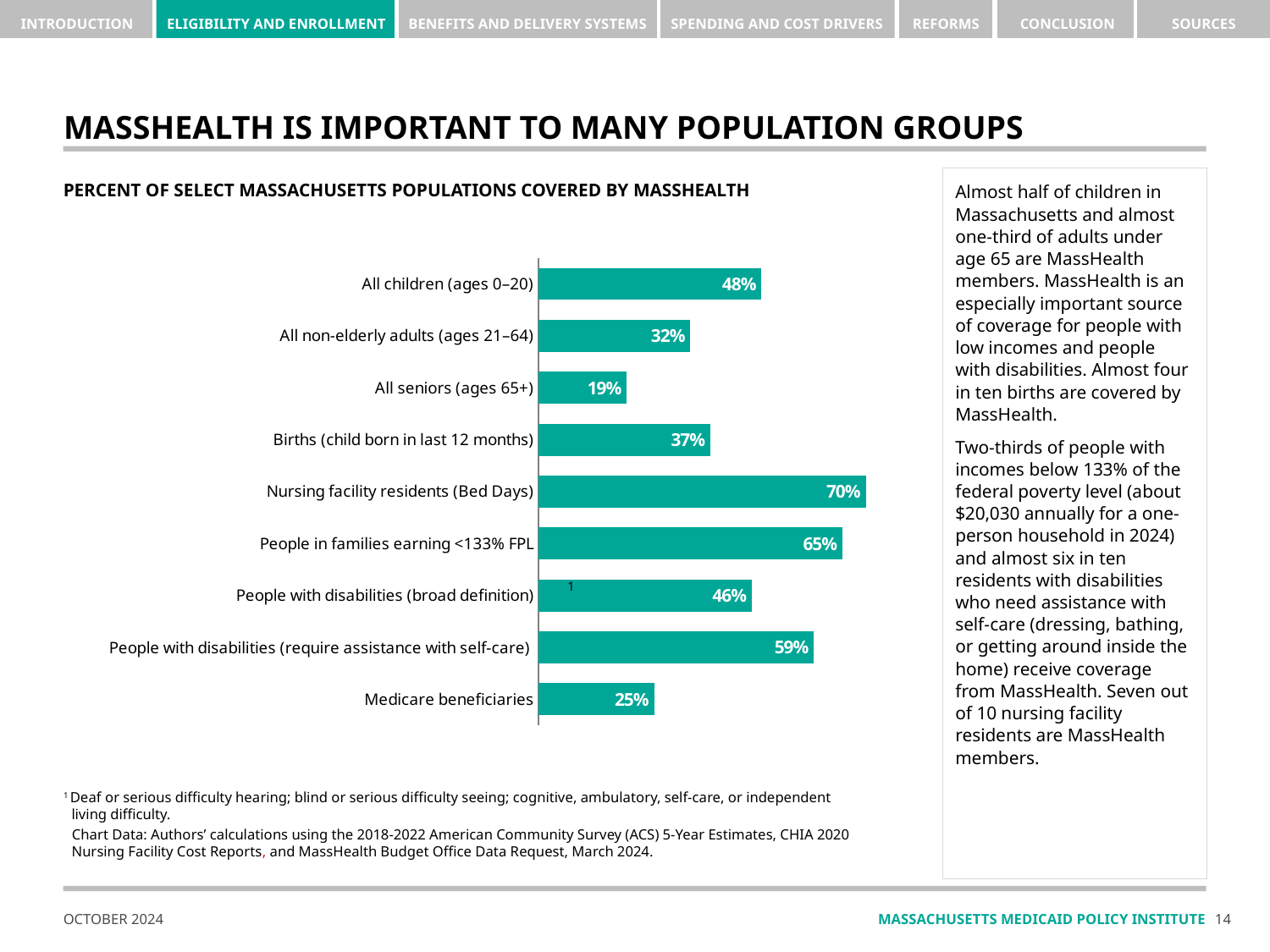
Which is larger: the value for births (child born in last 12 months) or the value for people with disabilities (broad definition)? People with disabilities (broad definition) How many population groups are shown in the chart? 9 What is the value for people with disabilities (require assistance with self-care)? 59% Which population group has the lowest percent covered by MassHealth? All seniors (ages 65+) Which population group has the highest percent covered by MassHealth? Nursing facility residents (Bed Days) What percent of Medicare beneficiaries are covered by MassHealth? 25% What is the title of the chart? Percent of select Massachusetts populations covered by MassHealth What is the value for nursing facility residents (Bed Days)? 70% What is the difference between the value for people in families earning <133% FPL and the value for all non-elderly adults (ages 21–64)? 33 percentage points What is the difference between the value for all children (ages 0–20) and the value for all seniors (ages 65+)? 29 percentage points What kind of chart is shown on the slide? Bar chart What percent of all children (ages 0–20) are covered by MassHealth? 48%